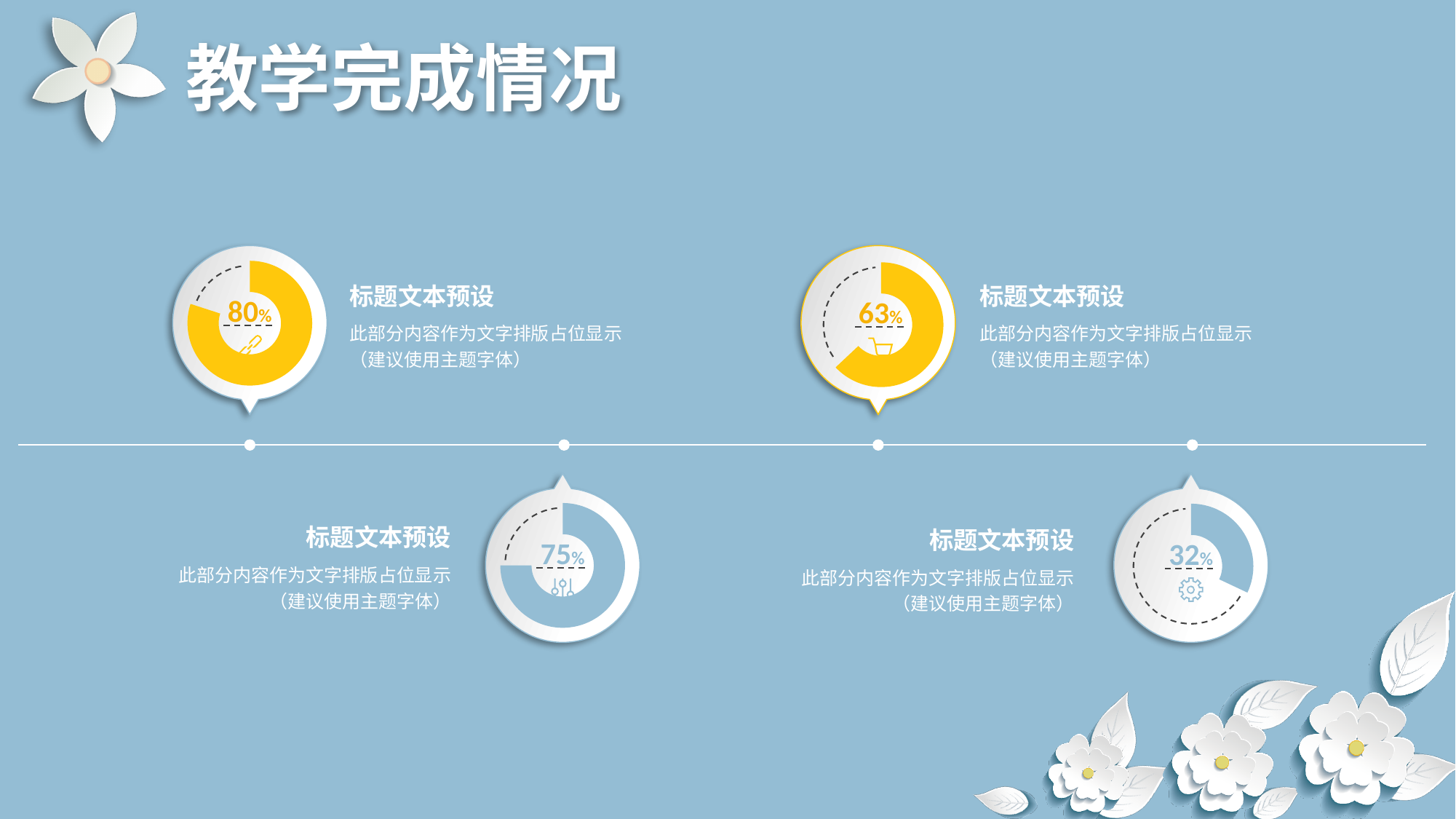
Which of the four circular charts on the slide shows the highest percentage? The top-left chart (80%) What is the difference between the value in the top-left chart and the value in the top-right chart? 17% What value is shown in the bottom-left circular chart on the slide? 75% What value is shown in the bottom-right circular chart on the slide? 32% Which is larger, the value in the top-right chart or the value in the bottom-left chart? The bottom-left chart (75%) What value is shown in the top-right circular chart on the slide? 63% What value is shown in the top-left circular chart on the slide? 80% What is the difference between the value in the top-left chart and the value in the bottom-right chart? 48% What colour is the filled portion of the two charts in the top row? Yellow How many circular percentage charts are on the slide? 4 What kind of chart is used to show each percentage on the slide? Donut (circular progress) chart Which of the four circular charts on the slide shows the lowest percentage? The bottom-right chart (32%)